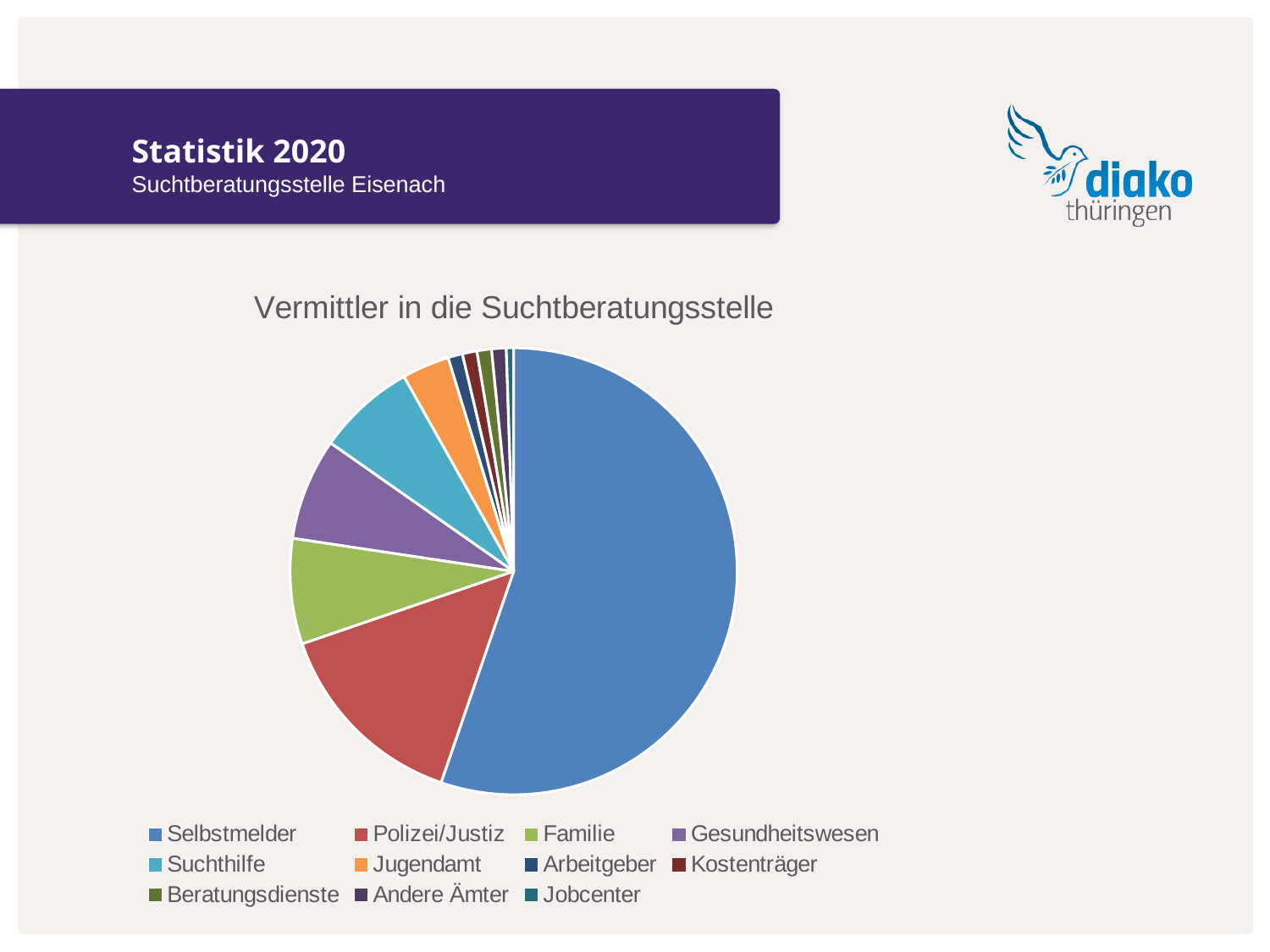
Which category has the smallest slice of the pie? Jobcenter What kind of chart is shown on the slide? pie chart What is the title of the chart? Vermittler in die Suchtberatungsstelle Which category is the second largest slice of the pie? Polizei/Justiz What colour is the Selbstmelder slice? blue Which slice is larger, Gesundheitswesen or Arbeitgeber? Gesundheitswesen Which slice is larger, Suchthilfe or Jugendamt? Suchthilfe How many categories does the pie chart have? 11 Which category has the largest slice of the pie? Selbstmelder Which slice is larger, Polizei/Justiz or Familie? Polizei/Justiz